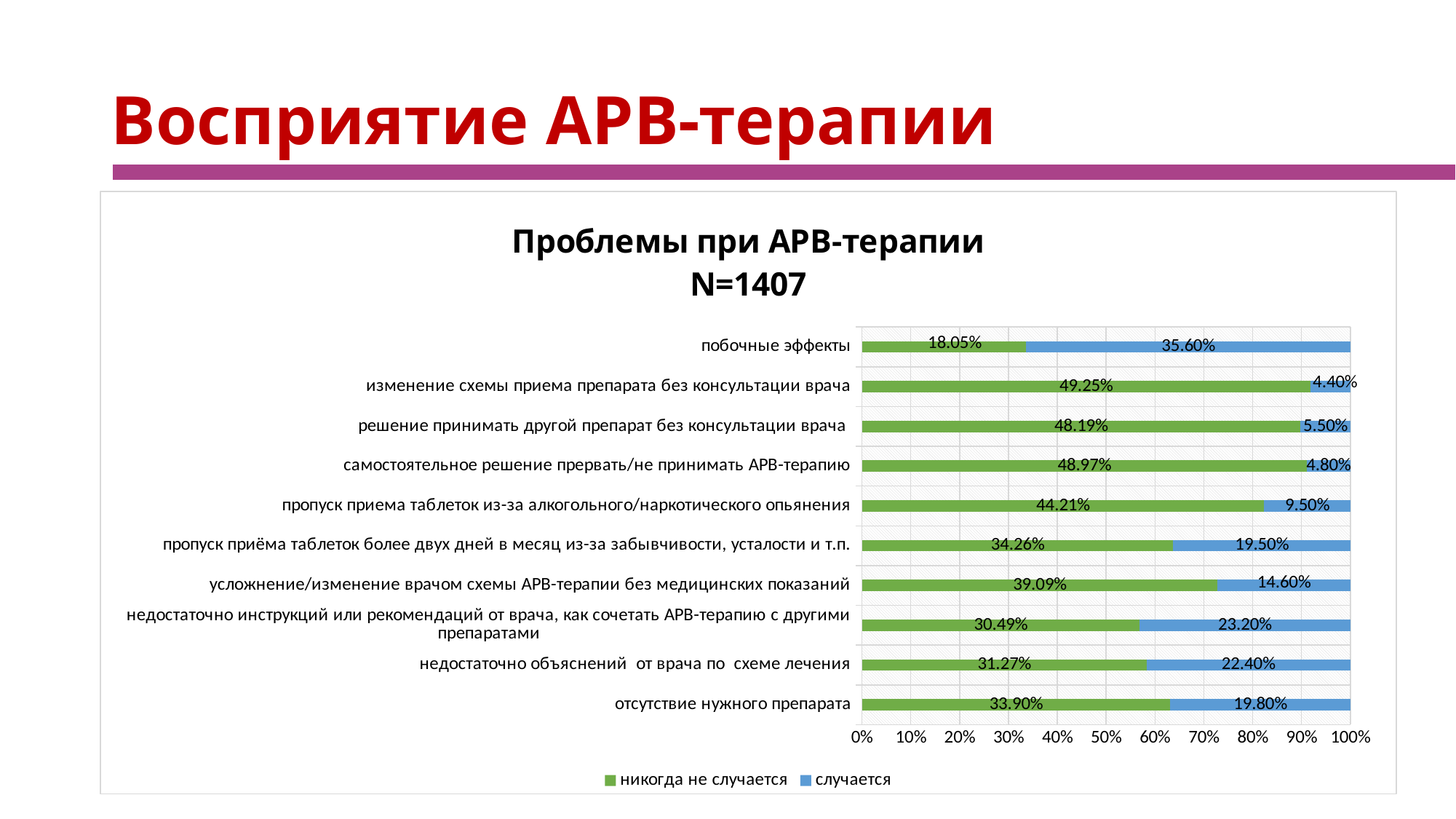
Which category has the lowest value for "случается"? изменение схемы приема препарата без консультации врача What is the difference between the "случается" and "никогда не случается" values for "побочные эффекты"? 17.55% What is the value of "случается" for "побочные эффекты"? 35.60% What kind of chart is shown on the slide? Stacked bar chart Which is larger: the "случается" value for "недостаточно объяснений от врача по схеме лечения" or for "усложнение/изменение врачом схемы АРВ-терапии без медицинских показаний"? недостаточно объяснений от врача по схеме лечения Which category has the highest value for "случается"? побочные эффекты Which category has the highest value for "никогда не случается"? изменение схемы приема препарата без консультации врача How many series does the legend list? 2 Which series is shown in green in the legend? никогда не случается What is the value of "никогда не случается" for "отсутствие нужного препарата"? 33.90% How many categories are shown in the chart? 10 What is the value of "случается" for "пропуск приема таблеток из-за алкогольного/наркотического опьянения"? 9.50%